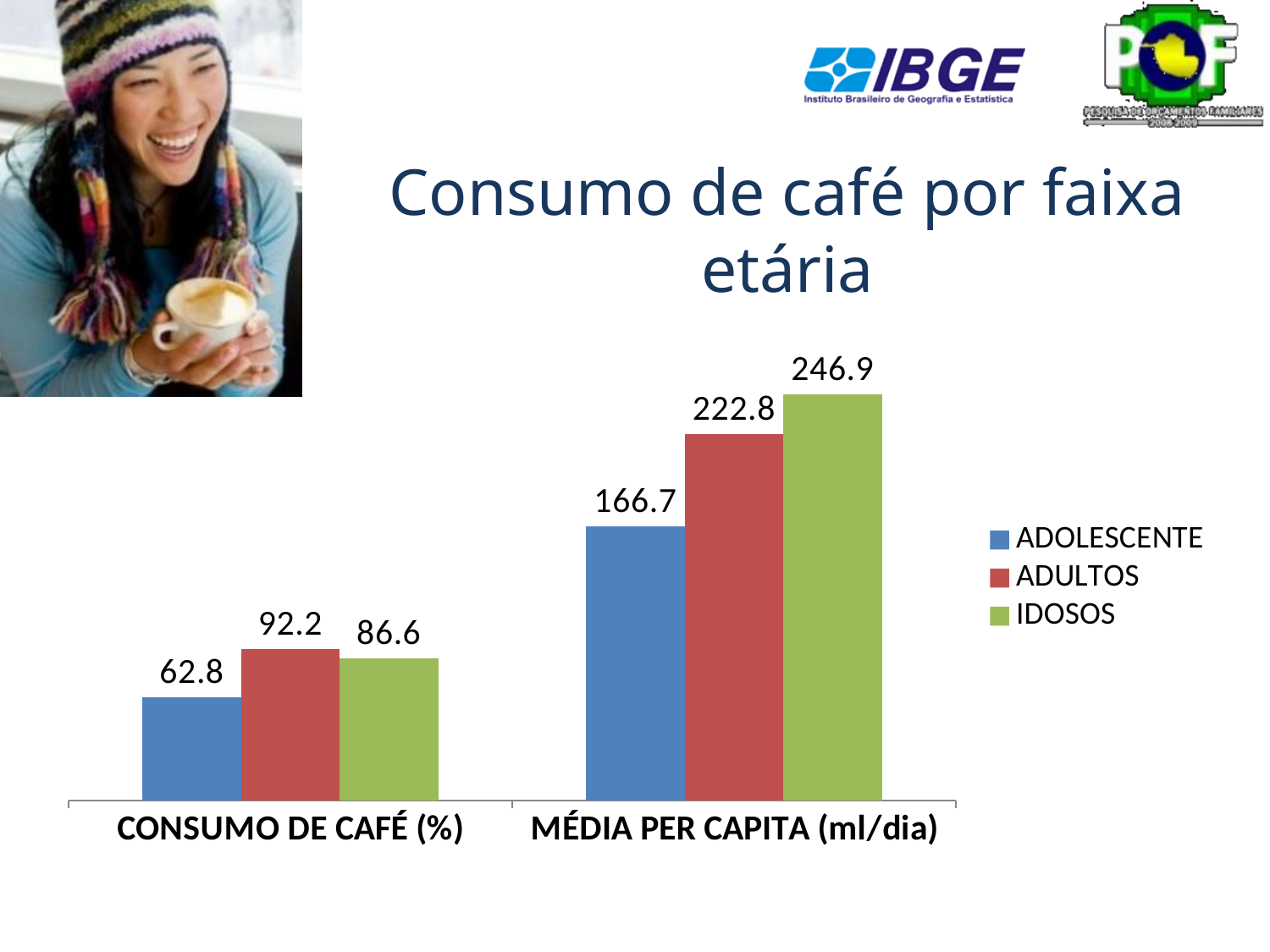
What is the difference between the ADULTOS and ADOLESCENTE values in the CONSUMO DE CAFÉ (%) category? 29.4 What kind of chart is shown on the slide? Bar chart How many categories are shown on the x axis? 2 What is the value for IDOSOS in the MÉDIA PER CAPITA (ml/dia) category? 246.9 What is the value for IDOSOS in the CONSUMO DE CAFÉ (%) category? 86.6 How many series does the legend list? 3 Which series has the highest value in the CONSUMO DE CAFÉ (%) category? ADULTOS What is the difference between the IDOSOS and ADULTOS values in the MÉDIA PER CAPITA (ml/dia) category? 24.1 What is the value for ADOLESCENTE in the CONSUMO DE CAFÉ (%) category? 62.8 Which series has the lowest value in the MÉDIA PER CAPITA (ml/dia) category? ADOLESCENTE In the MÉDIA PER CAPITA (ml/dia) category, which is larger: ADULTOS or ADOLESCENTE? ADULTOS What is the value for ADULTOS in the MÉDIA PER CAPITA (ml/dia) category? 222.8